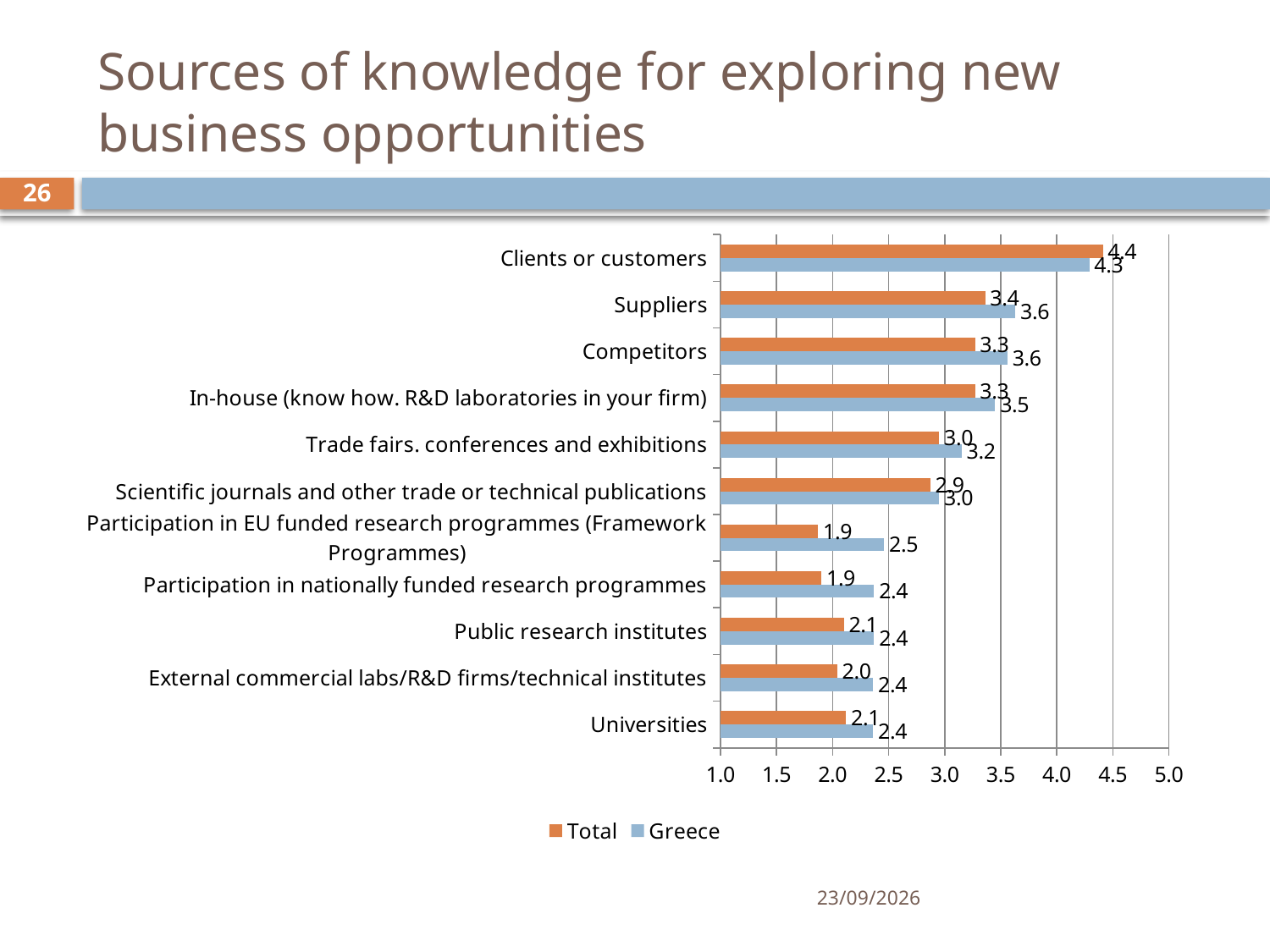
What kind of chart is shown on the slide? Bar chart What is the Greece value for Suppliers? 3.6 How many categories are shown on the chart? 11 What is the Greece value for Participation in EU funded research programmes (Framework Programmes)? 2.5 For Clients or customers, which is larger: the Total value or the Greece value? Total What is the difference between the Greece and Total values for Competitors? 0.3 Which category has the highest Greece value? Clients or customers Which series is shown in orange? Total What is the Total value for Clients or customers? 4.4 What is the Total value for External commercial labs/R&D firms/technical institutes? 2.0 How many series does the legend list? 2